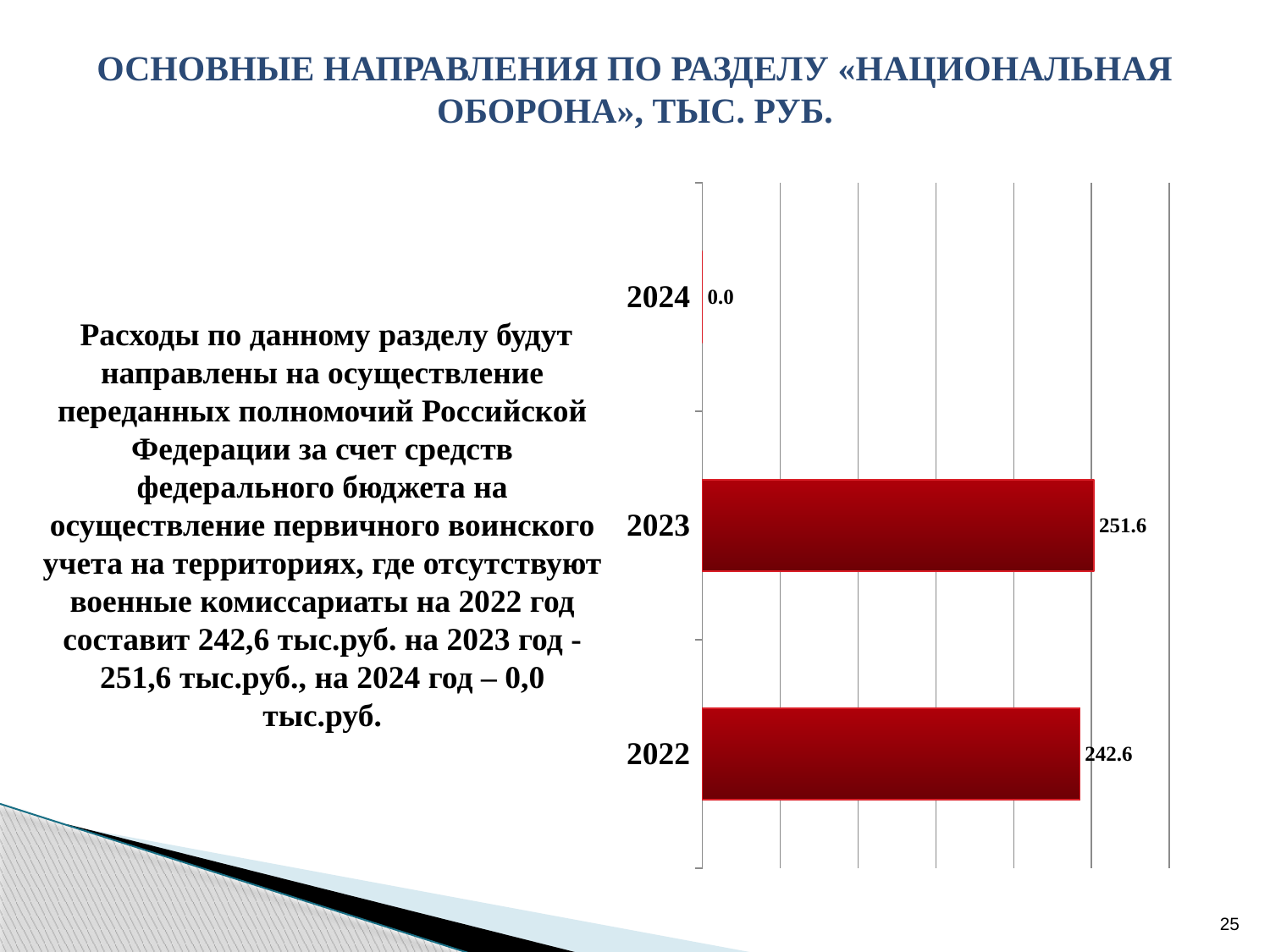
What is the value for 2023? 251.6 Which year has the lowest value? 2024 What kind of chart is shown on the slide? bar chart How many years are shown on the chart? 3 Which is larger, the value for 2022 or the value for 2023? 2023 What is the value for 2024? 0.0 What colour are the bars in the chart? red Are the bars in the chart horizontal or vertical? horizontal What is the difference between the values for 2023 and 2022? 9.0 What is the value for 2022? 242.6 What is the total of the values for 2022, 2023 and 2024? 494.2 Which year has the highest value? 2023